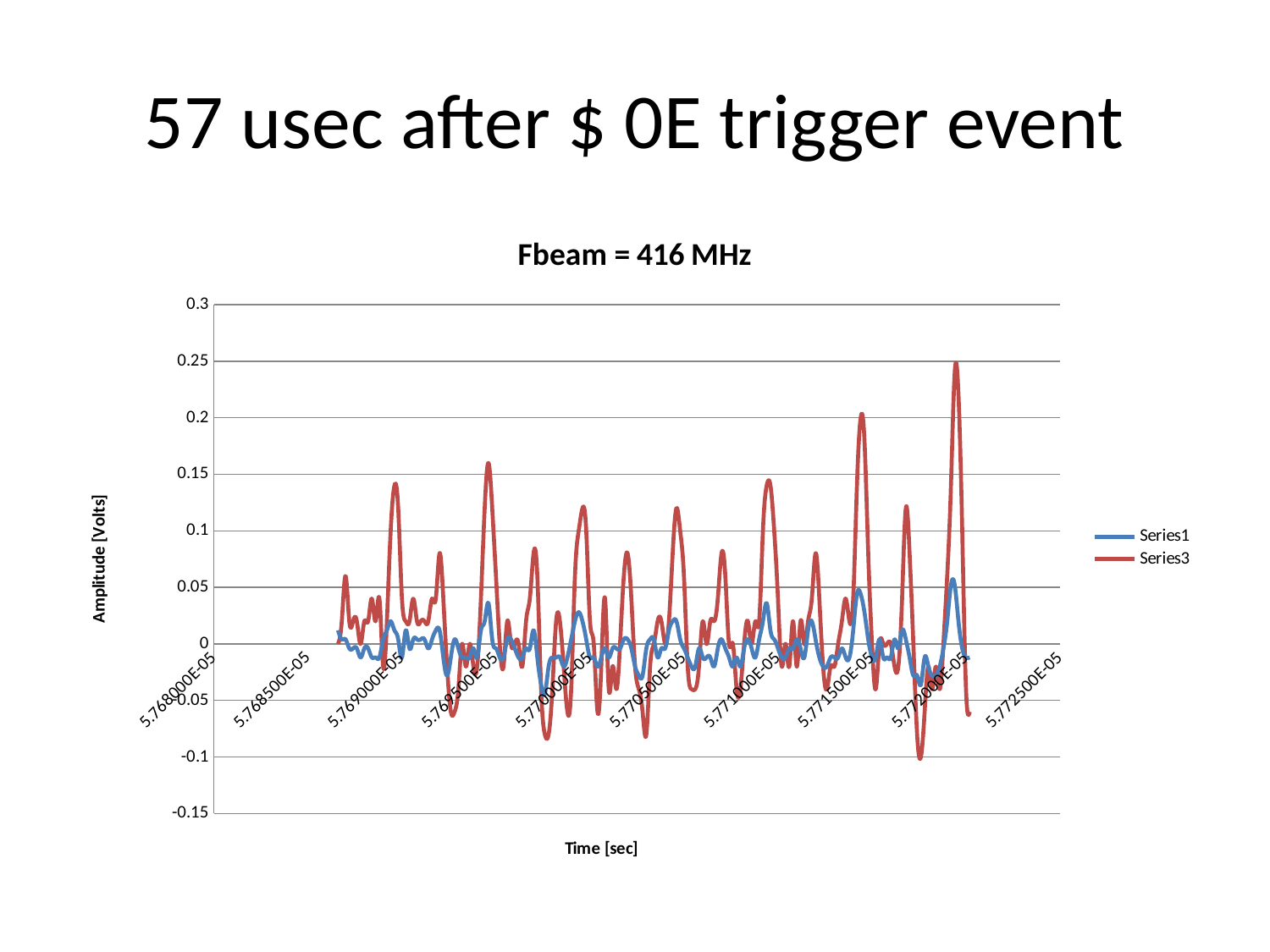
Is the lowest value reached by Series3 greater or less than -0.05? less Which series reaches the higher peak amplitude, Series1 or Series3? Series3 Is the highest value reached by Series3 greater or less than 0.3? less How many series does the legend list? 2 Which series shows the larger swings in amplitude over time? Series3 Is the highest value reached by Series3 greater or less than 0.2? greater What is the title of the chart? Fbeam = 416 MHz What are the two entries in the chart legend? Series1 and Series3 What kind of chart is shown on the slide? line chart